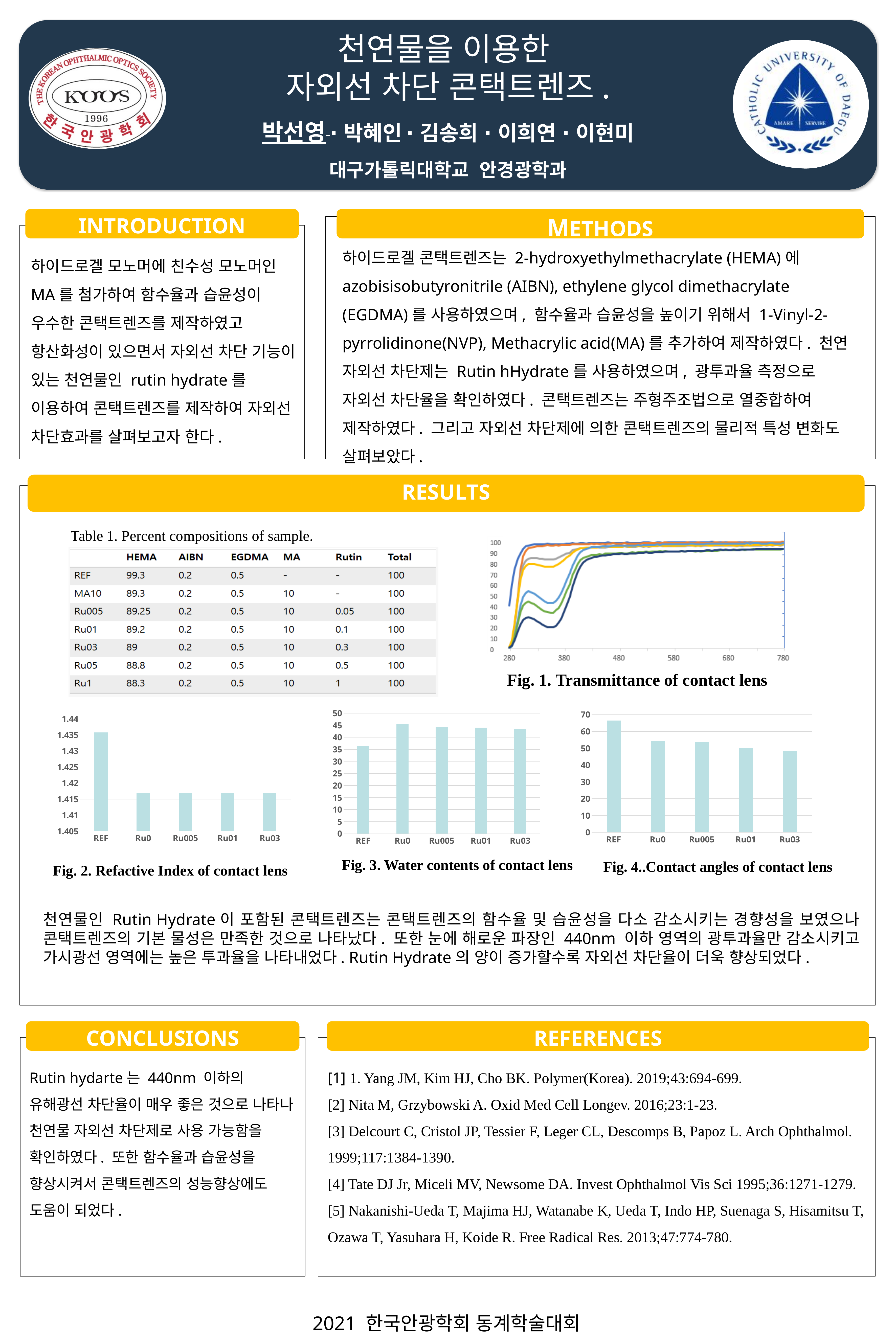
What kind of chart is Fig. 1. Transmittance of contact lens? line chart In Fig. 3. Water contents of contact lens, is the value for Ru0 greater or less than 40? greater In Fig. 4..Contact angles of contact lens, do the values rise or fall from REF to Ru03 along the x axis? fall In Fig. 3. Water contents of contact lens, which category has the lowest value? REF What kind of chart is Fig. 2. Refactive Index of contact lens? bar chart In Fig. 2. Refactive Index of contact lens, which category has the highest value? REF In Fig. 2. Refactive Index of contact lens, how many categories are shown on the x axis? 5 In Fig. 4..Contact angles of contact lens, is the value for REF greater or less than 60? greater In Fig. 4..Contact angles of contact lens, which is larger, the value for Ru0 or the value for Ru03? Ru0 In Fig. 2. Refactive Index of contact lens, is the value for REF greater or less than 1.43? greater In Fig. 4..Contact angles of contact lens, which category has the highest value? REF